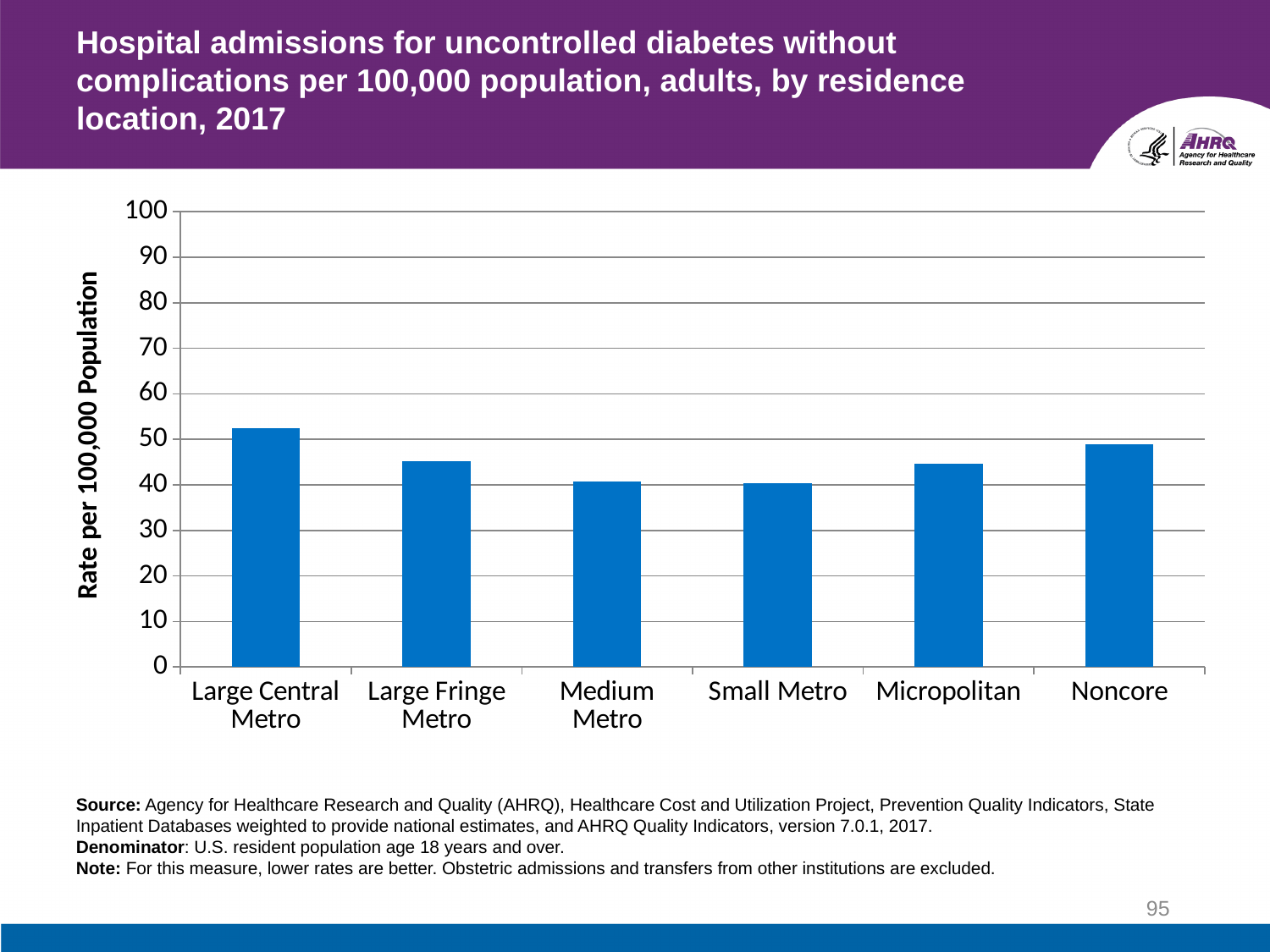
Which is larger, the value for Large Fringe Metro or the value for Medium Metro? Large Fringe Metro What kind of chart is shown on the slide? Bar chart Is the value for Micropolitan greater or less than 40? greater Is the value for Small Metro greater or less than 50? less What is the label on the y axis of the chart? Rate per 100,000 Population Is the value for Large Central Metro greater or less than 50? greater Which residence location has the highest rate of hospital admissions for uncontrolled diabetes without complications? Large Central Metro How many residence location categories are shown on the x axis? 6 Which is larger, the value for Large Central Metro or the value for Noncore? Large Central Metro